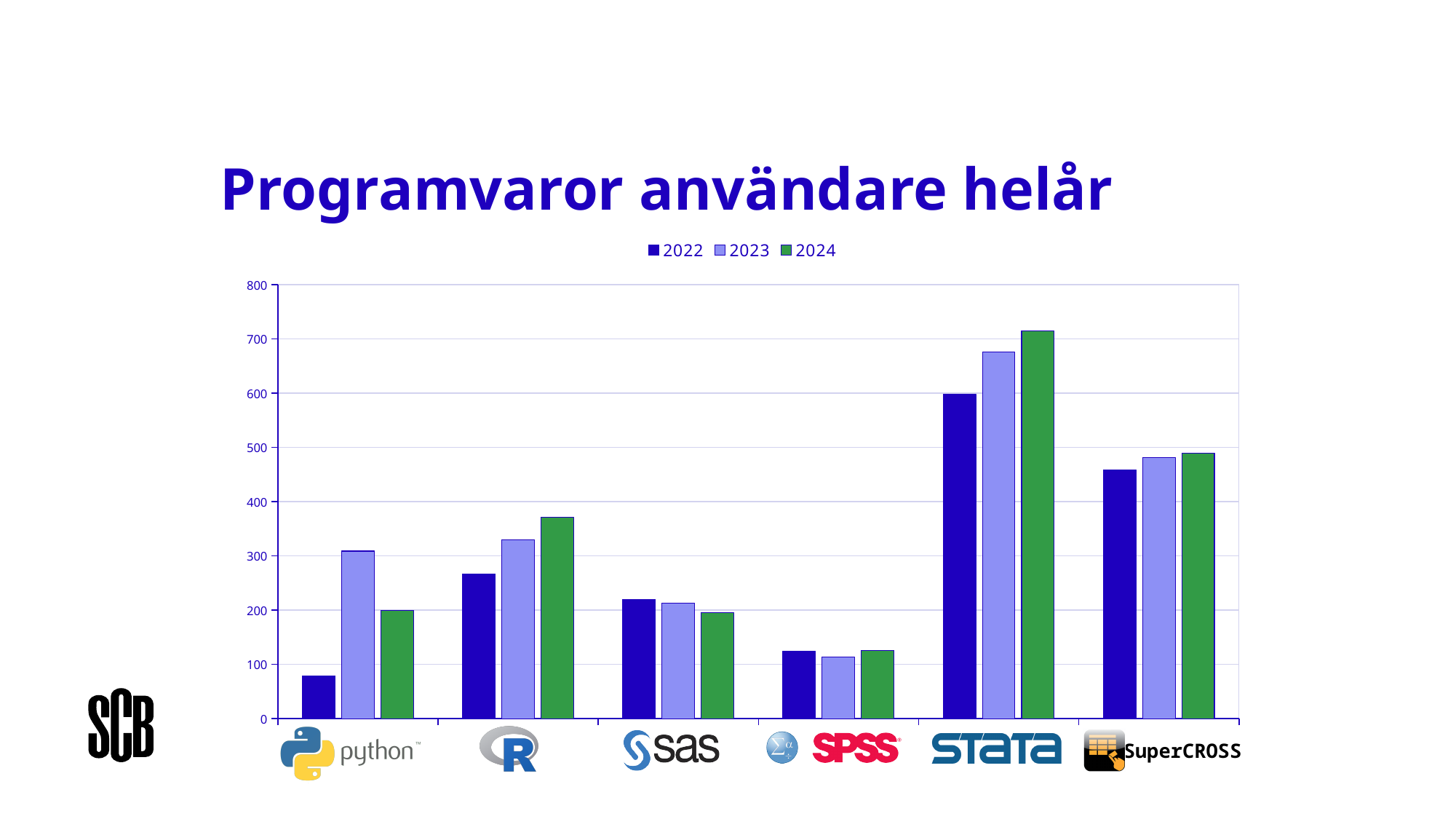
How many software categories are shown along the x axis? 6 Which software has the highest value for 2024? Stata Which software has the lowest value for 2022? Python How many series does the legend list? 3 Is the value for SuperCROSS in 2023 greater or less than 500? less Which is larger for R: the 2022 value or the 2024 value? 2024 What kind of chart is shown on the slide? bar chart Do the values for Stata rise or fall from 2022 to 2024? rise Is the value for Python in 2022 greater or less than 100? less Is the value for Stata in 2024 greater or less than 700? greater Which is larger in 2023: Python or SAS? Python What is the title of the chart? Programvaror användare helår